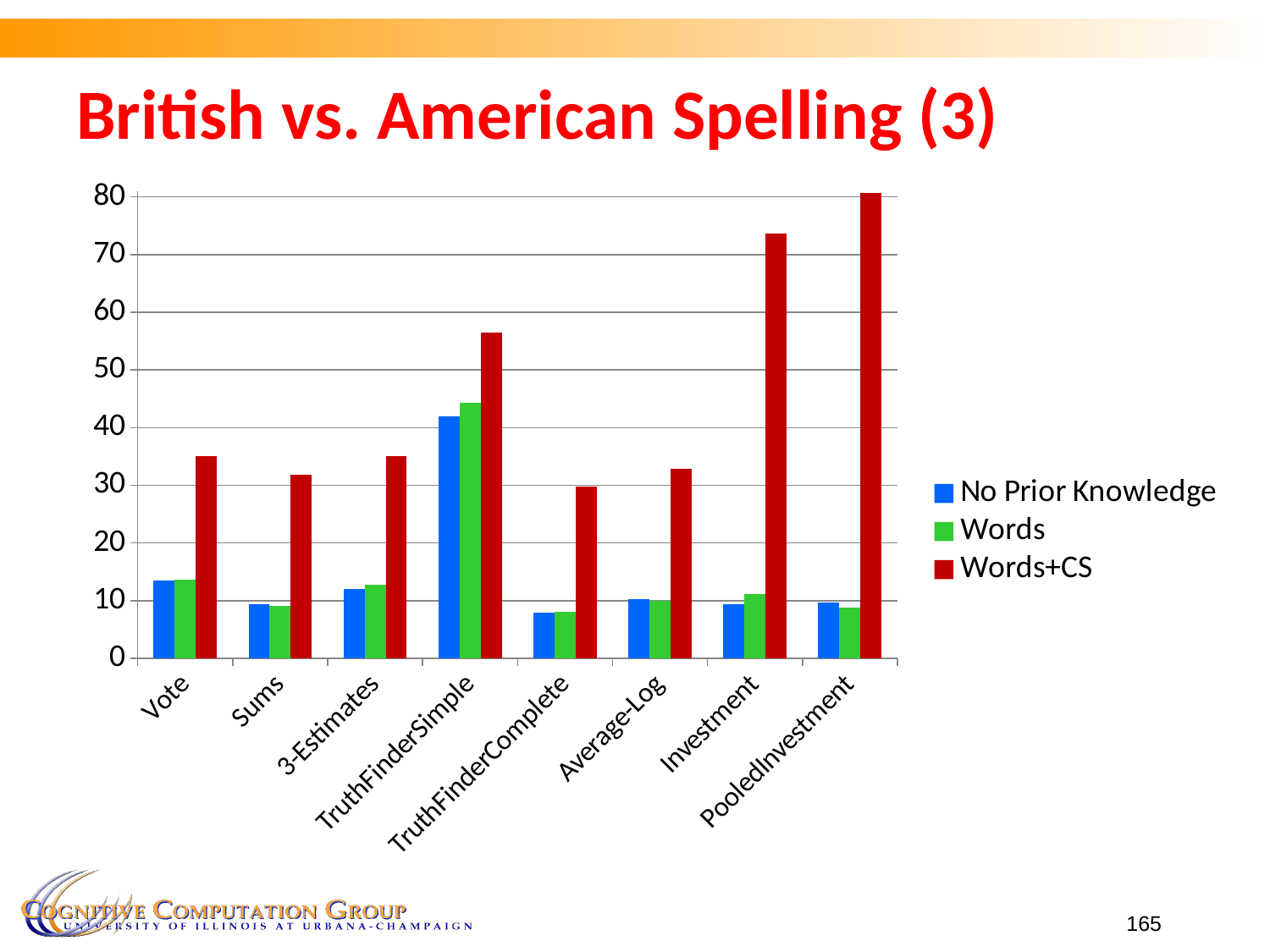
How many series does the legend list? 3 Is the No Prior Knowledge value for TruthFinderSimple greater or less than 40? greater How many categories are shown along the x axis? 8 Which category has the highest No Prior Knowledge value? TruthFinderSimple Which is larger, the Words+CS value for TruthFinderSimple or the Words+CS value for PooledInvestment? PooledInvestment What kind of chart is shown on the slide? bar chart Which category has the highest Words+CS value? PooledInvestment Is the Words+CS value for TruthFinderComplete greater or less than 20? greater Is the Words value for Vote greater or less than 20? less What colour are the Words+CS bars? red Which is larger, the Words+CS value for Investment or the Words+CS value for Vote? Investment